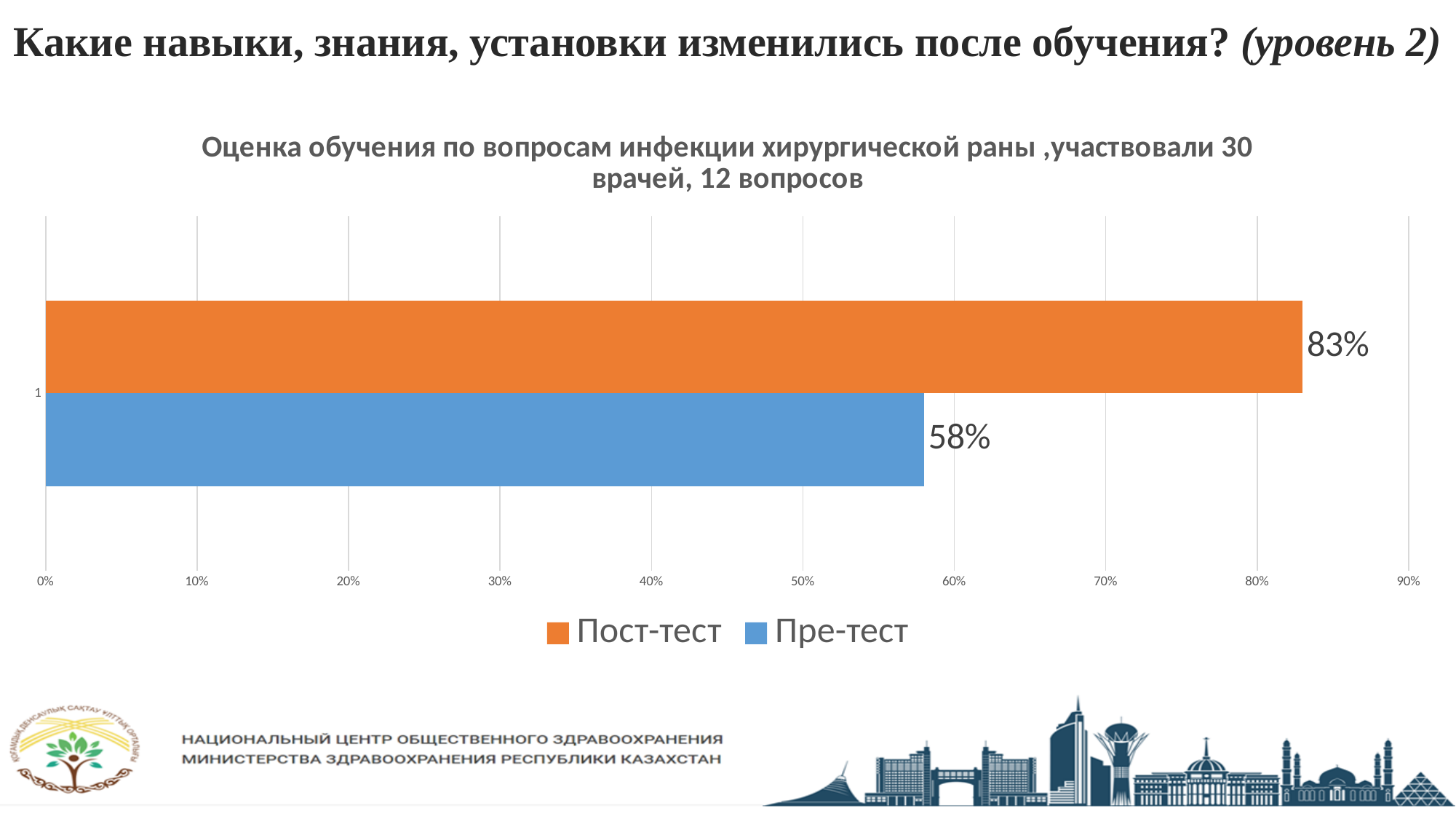
How many bars are plotted in the chart? 2 How many series does the legend list? 2 Is the value for Пре-тест greater or less than 60%? less Which series has the higher value, Пост-тест or Пре-тест? Пост-тест What is the difference between the Пост-тест and Пре-тест values? 25% What is the value for Пре-тест? 58% What kind of chart is shown on the slide? bar chart What is the maximum value shown on the x axis? 90% Which series has the lowest value? Пре-тест What is the value for Пост-тест? 83% Is the value for Пост-тест greater or less than 80%? greater What colour is the Пост-тест bar? orange